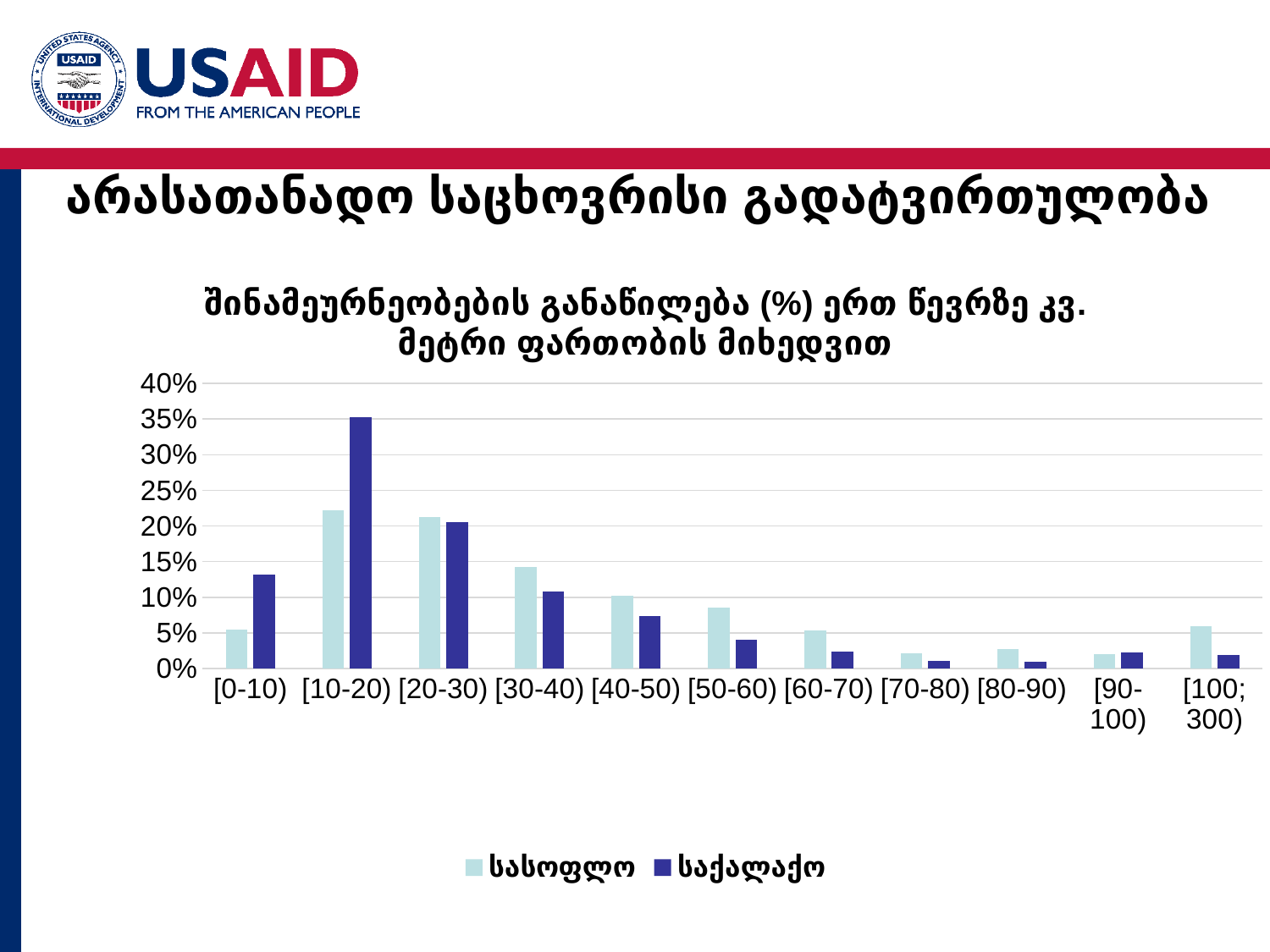
How many series does the chart legend list? 2 What kind of chart is shown on the slide? bar chart Is the საქალაქო value for [50-60) greater or less than 5%? less How many area categories are shown on the x axis of the chart? 11 Is the საქალაქო value for [10-20) greater or less than 30%? greater Is the საქალაქო value for [0-10) greater or less than 10%? greater For the საქალაქო series, which category has the highest value? [10-20) In the [100;300) category, which series has the larger value, სასოფლო or საქალაქო? სასოფლო For the სასოფლო series, which category has the highest value? [10-20) In the [0-10) category, which series has the larger value, სასოფლო or საქალაქო? საქალაქო What are the two series named in the chart legend? სასოფლო and საქალაქო